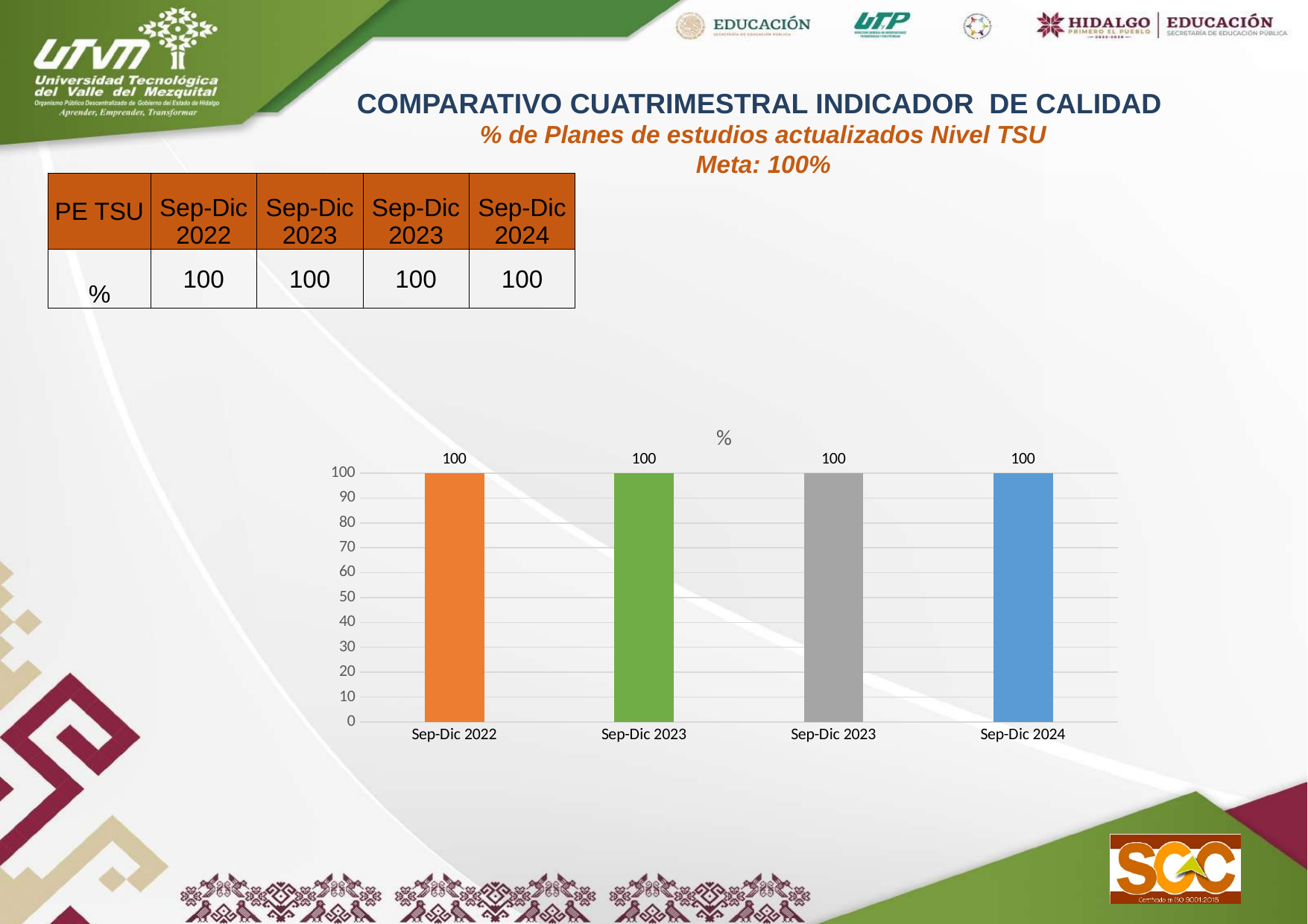
How many bars are plotted in the chart? 4 What is the label of the last category on the x axis? Sep-Dic 2024 Is the value for Sep-Dic 2024 greater or less than 50? greater What kind of chart is shown on the slide? bar chart What is the value of the bar for Sep-Dic 2022? 100 What is the title shown above the chart? % What is the highest value shown on the vertical axis? 100 Do the values rise, fall, or stay flat from Sep-Dic 2022 to Sep-Dic 2024? stay flat What is the value of the bar for Sep-Dic 2024? 100 What colour is the bar for Sep-Dic 2022? orange What is the difference between the values for Sep-Dic 2022 and Sep-Dic 2024? 0